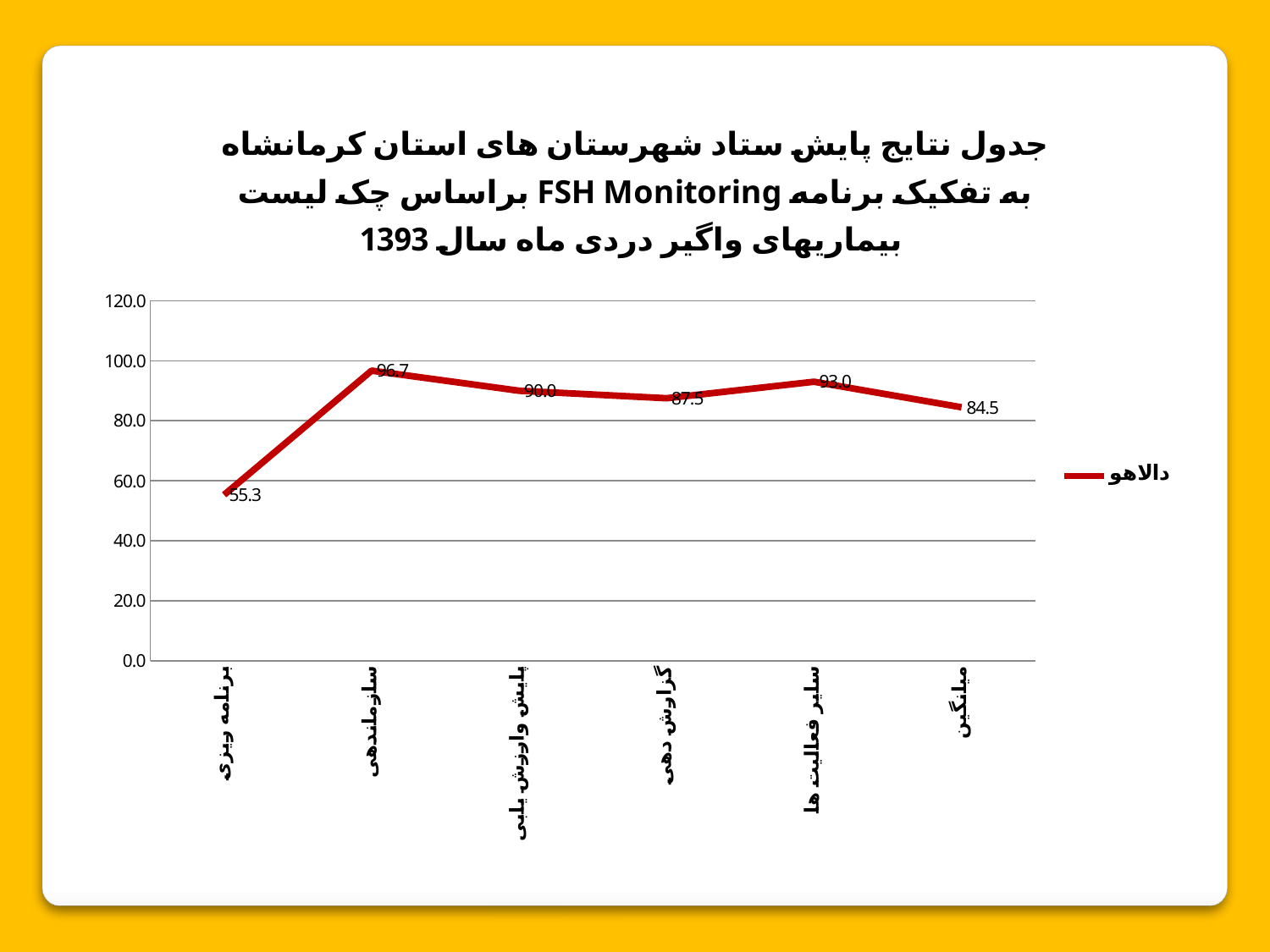
What is the value for سازماندهی? 96.7 What is the value for میانگین? 84.5 Which category has the lowest value? برنامه ریزی What is the value for گزارش دهی? 87.5 What series name does the legend show? دالاهو What is the difference between the values for سازماندهی and برنامه ریزی? 41.4 How many categories are plotted on the x axis? 6 What is the value for سایر فعالیت ها? 93.0 What is the value for برنامه ریزی? 55.3 What kind of chart is shown on the slide? line chart Which category has the highest value? سازماندهی Which is larger, the value for سایر فعالیت ها or the value for گزارش دهی? سایر فعالیت ها